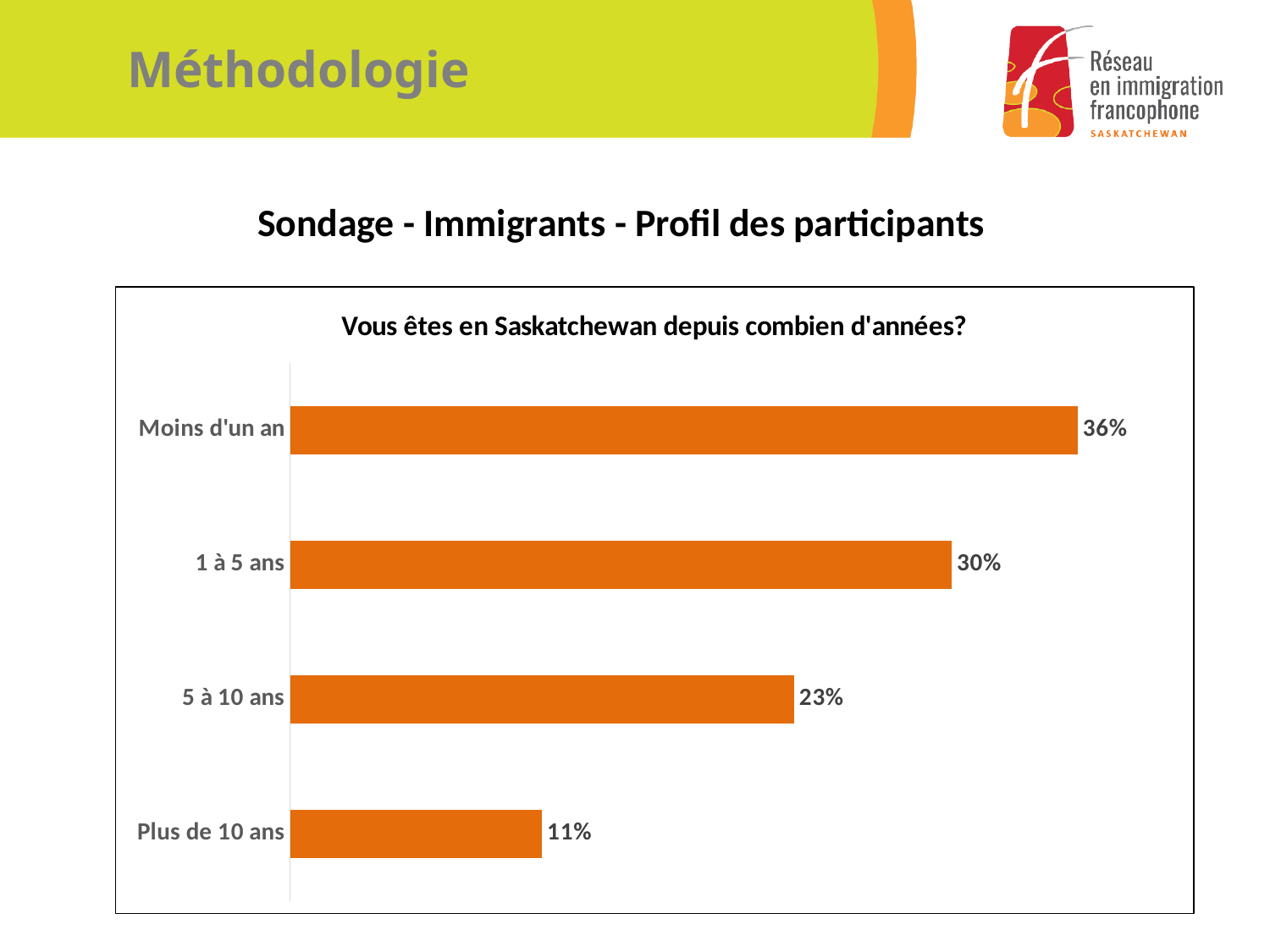
What kind of chart is shown on the slide? Bar chart What is the difference between the values for "1 à 5 ans" and "5 à 10 ans"? 7% What is the difference between the values for "Moins d'un an" and "Plus de 10 ans"? 25% What is the value for "5 à 10 ans"? 23% Which is larger, the value for "1 à 5 ans" or the value for "5 à 10 ans"? 1 à 5 ans Which category has the highest value? Moins d'un an What is the value for "Plus de 10 ans"? 11% Which category has the lowest value? Plus de 10 ans What is the title of the chart? Vous êtes en Saskatchewan depuis combien d'années? What is the value for "1 à 5 ans"? 30% How many categories are shown in the chart? 4 What is the value for "Moins d'un an"? 36%